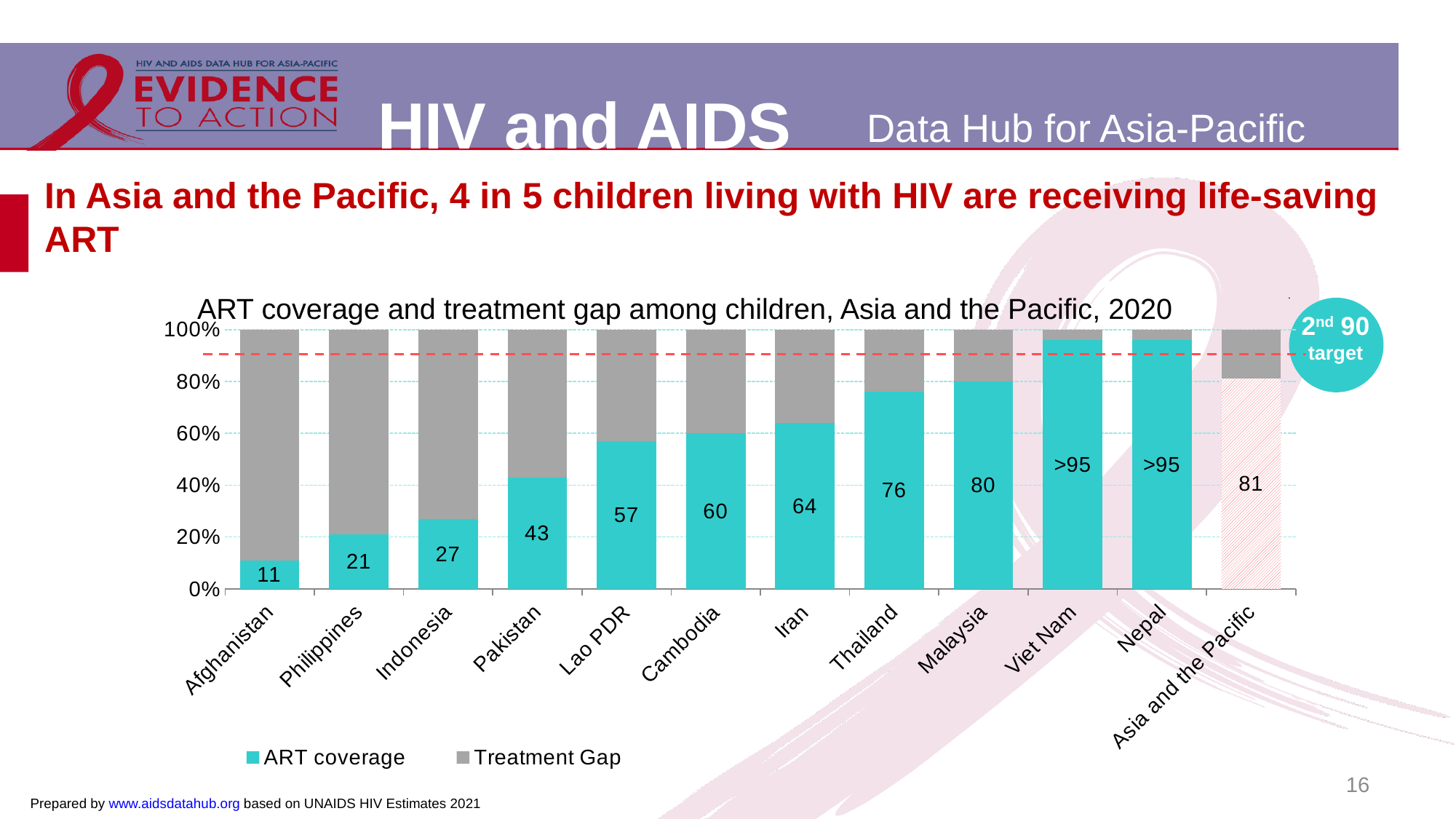
What type of chart is shown on the slide? Stacked bar chart Which country has the lowest ART coverage? Afghanistan What is the difference in ART coverage between Malaysia and Thailand? 4 What is the title of the chart? ART coverage and treatment gap among children, Asia and the Pacific, 2020 What is the ART coverage value for Nepal? >95 What is the ART coverage value for Thailand? 76 How many categories are shown on the x axis? 12 Is the Treatment Gap for Afghanistan greater or less than 80%? greater Which has higher ART coverage, Pakistan or Cambodia? Cambodia What is the ART coverage value for Asia and the Pacific? 81 What is the ART coverage value for Afghanistan? 11 How many series does the legend list? 2